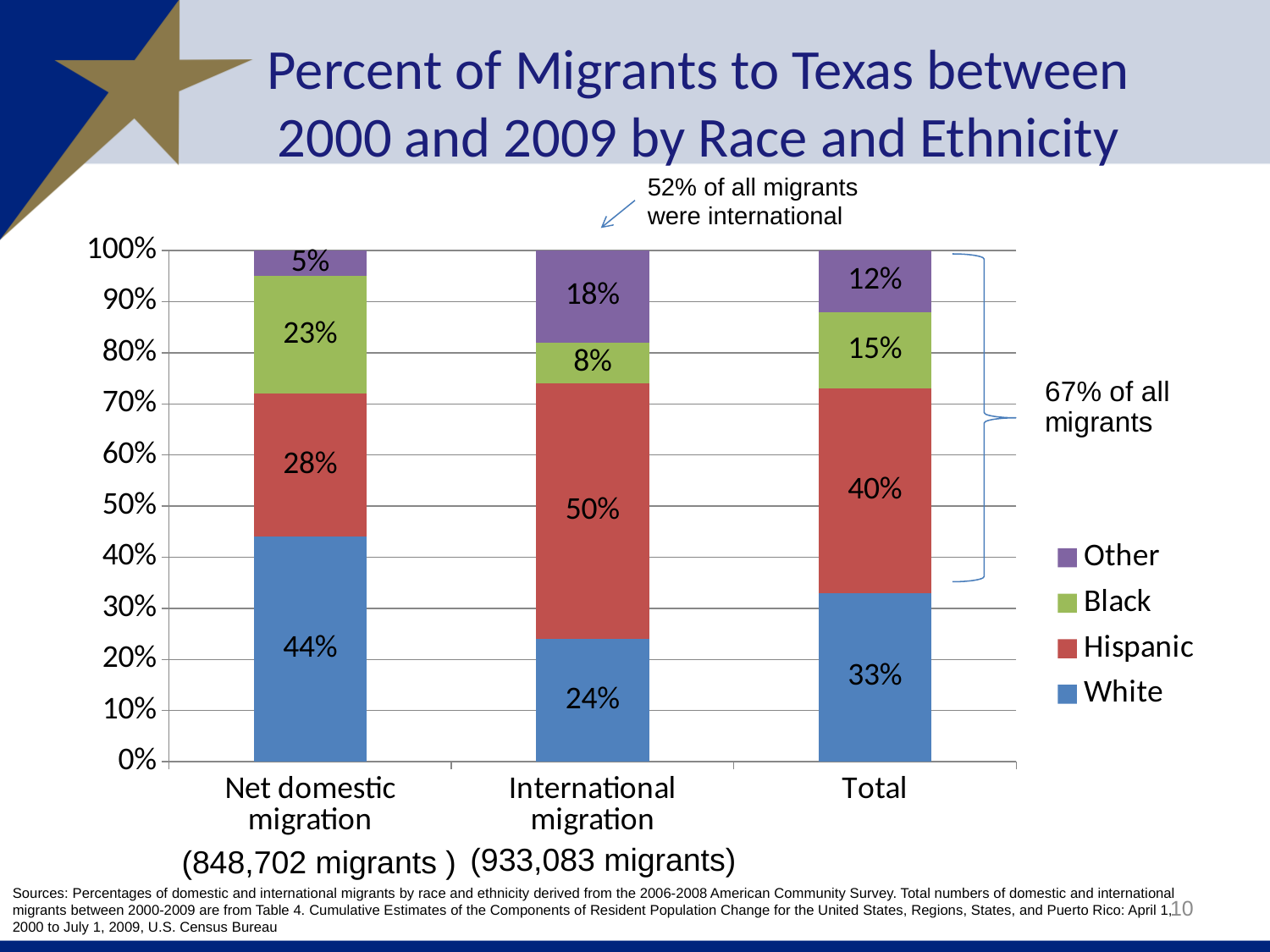
What kind of chart is shown on the slide? Stacked bar chart What percentage of international migration migrants were Hispanic? 50% How many migration categories are shown on the x axis? 3 What percentage of net domestic migration migrants were Other? 5% Which migration category has the lowest White share? International migration Is the Black share larger for net domestic migration or for international migration? Net domestic migration How many series does the legend list? 4 Which colour represents Hispanic in the chart? Red What is the difference between the Hispanic share of international migration and the Hispanic share of net domestic migration? 22% What percentage of total migrants were Black? 15% Which migration category has the highest Hispanic share? International migration What percentage of net domestic migration migrants were White? 44%